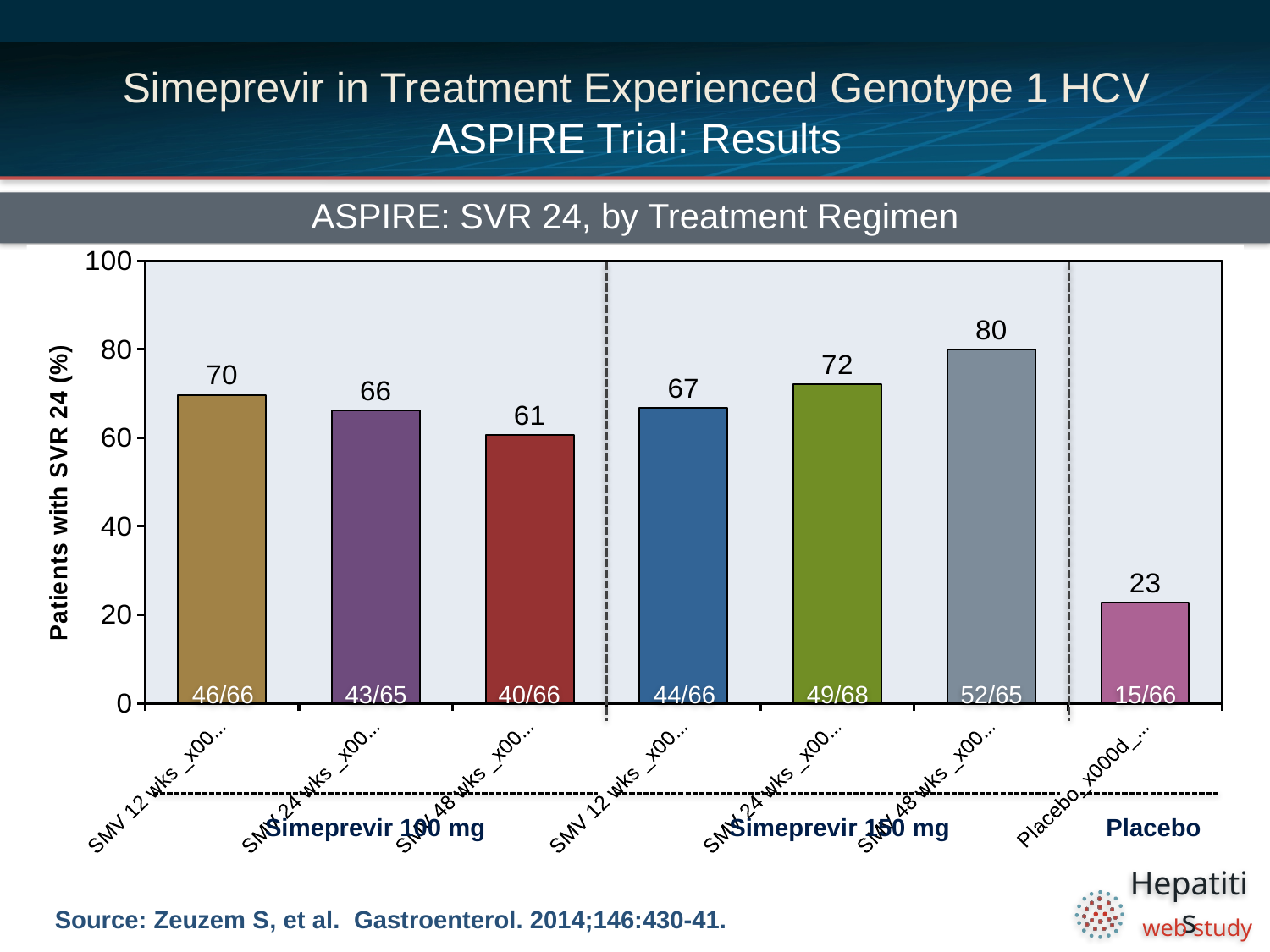
What is the difference in SVR 24 rate between the SMV 24 wks arms of the Simeprevir 150 mg and Simeprevir 100 mg groups? 6 Which has a higher SVR 24 rate: the SMV 12 wks arm in the Simeprevir 100 mg group or the SMV 12 wks arm in the Simeprevir 150 mg group? SMV 12 wks, Simeprevir 100 mg What is the SVR 24 rate for the SMV 48 wks arm in the Simeprevir 150 mg group? 80 Which treatment arm has the highest SVR 24 rate? SMV 48 wks, Simeprevir 150 mg What type of chart is shown on the slide? bar chart How many bars are plotted in the chart? 7 What fraction of patients is shown inside the bar for the SMV 24 wks arm in the Simeprevir 100 mg group? 43/65 What is the title of the y-axis? Patients with SVR 24 (%) Is the SVR 24 rate for the Placebo arm greater or less than 40? less Which treatment arm has the lowest SVR 24 rate? Placebo What is the difference in SVR 24 rate between the SMV 48 wks arm in the Simeprevir 150 mg group and the Placebo arm? 57 What is the SVR 24 rate for the Placebo arm? 23